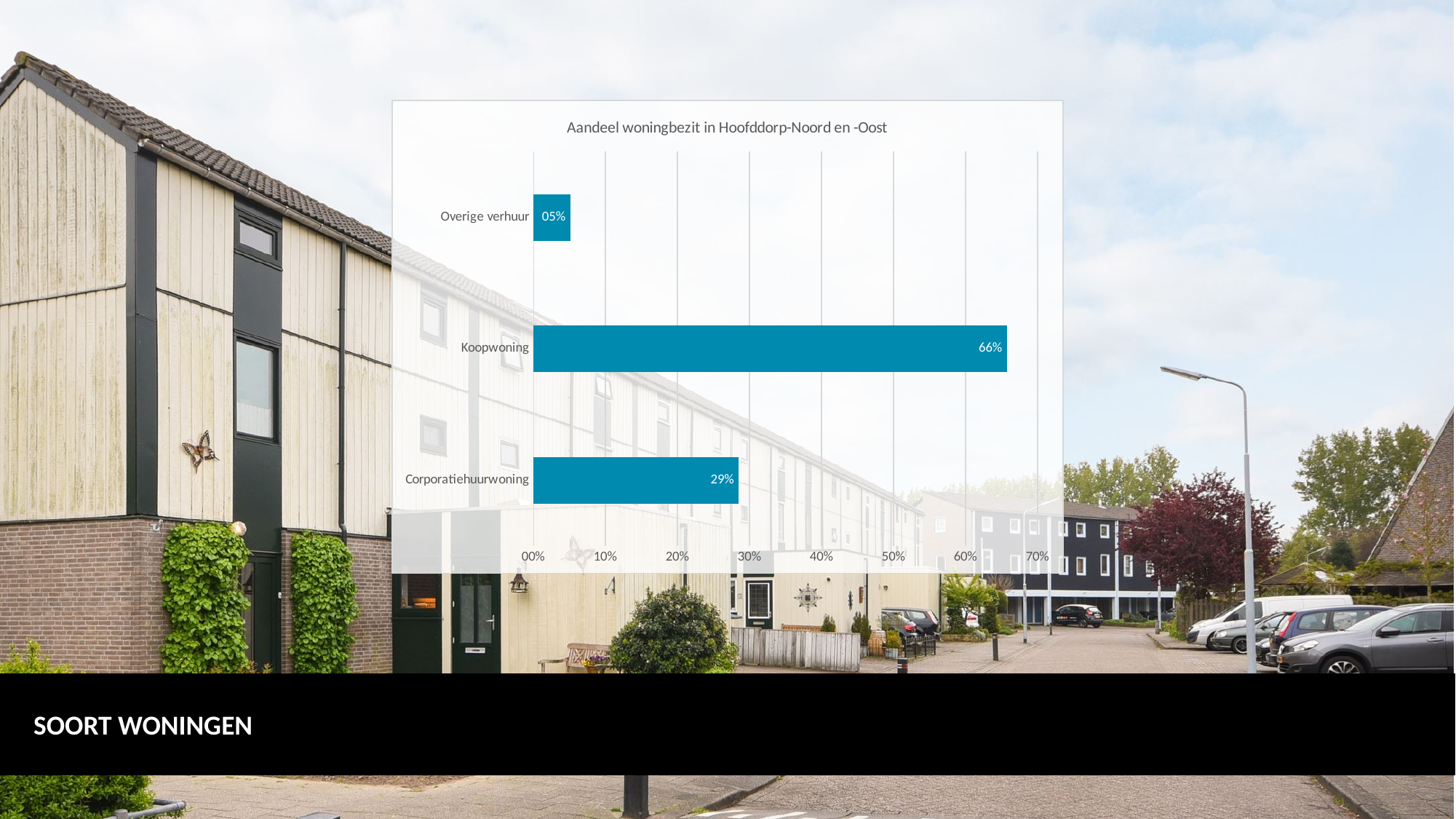
Which category has the highest value? Koopwoning What kind of chart is shown on the slide? bar chart What is the difference between the values for Koopwoning and Corporatiehuurwoning? 37% What is the highest value shown on the x axis? 70% What is the value for Koopwoning? 66% What is the title of the chart? Aandeel woningbezit in Hoofddorp-Noord en -Oost What is the value for Overige verhuur? 05% How many categories are shown in the chart? 3 Which category has the lowest value? Overige verhuur Which is larger, the value for Corporatiehuurwoning or the value for Overige verhuur? Corporatiehuurwoning What is the value for Corporatiehuurwoning? 29% Is the value for Koopwoning greater or less than 60%? greater